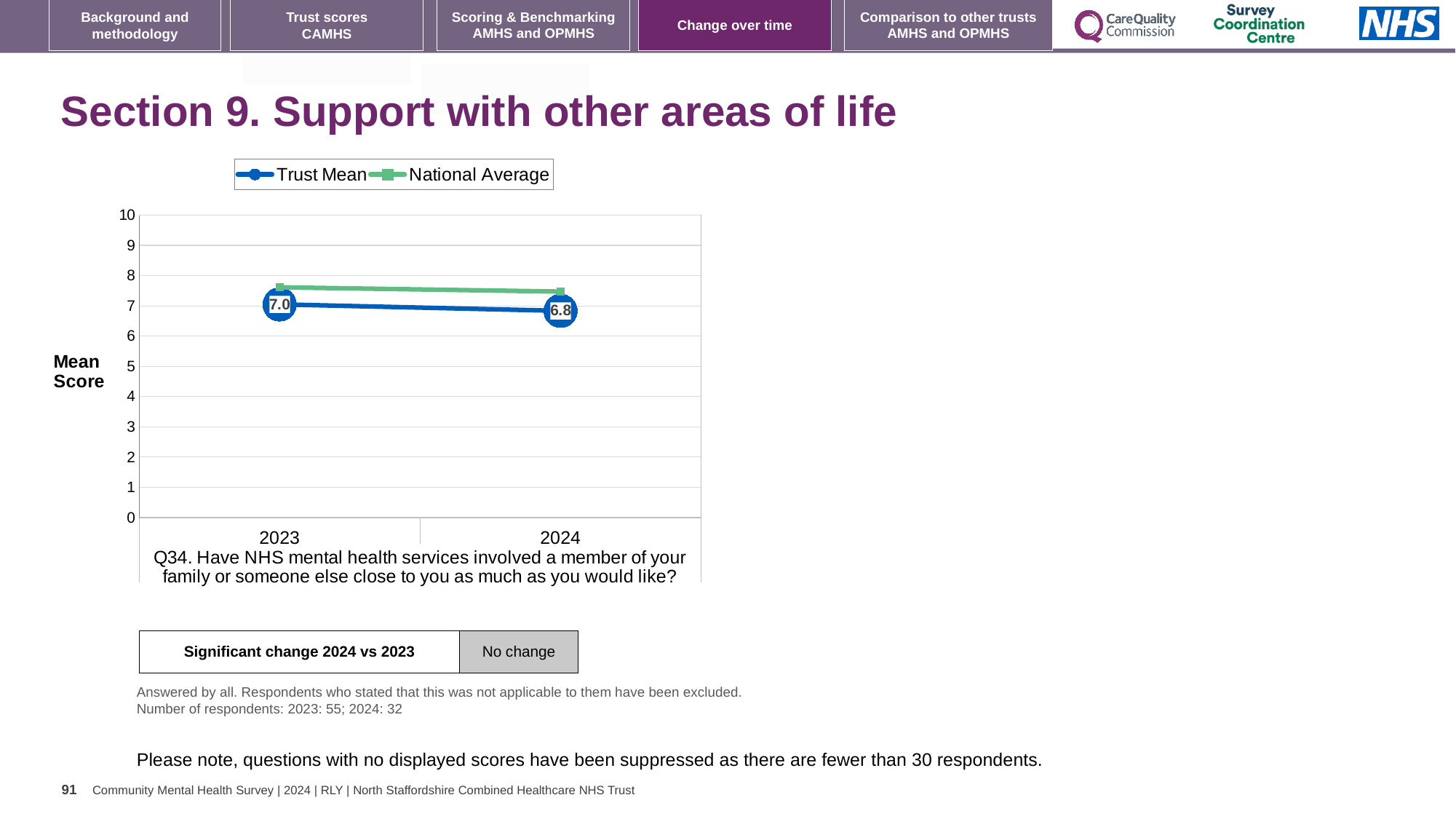
How many series does the legend list? 2 What is the Trust Mean score for 2024? 6.8 What is the Trust Mean score for 2023? 7.0 Is the National Average value for 2024 greater or less than 8? less By how much did the Trust Mean score change from 2023 to 2024? 0.2 What is the label on the y axis of the chart? Mean Score In 2024, which is higher, the Trust Mean or the National Average? National Average What kind of chart is shown on the slide? line chart How many years are plotted on the x axis? 2 Which year has the higher Trust Mean score, 2023 or 2024? 2023 Does the Trust Mean rise or fall from 2023 to 2024? fall Is the National Average value for 2023 greater or less than 7? greater